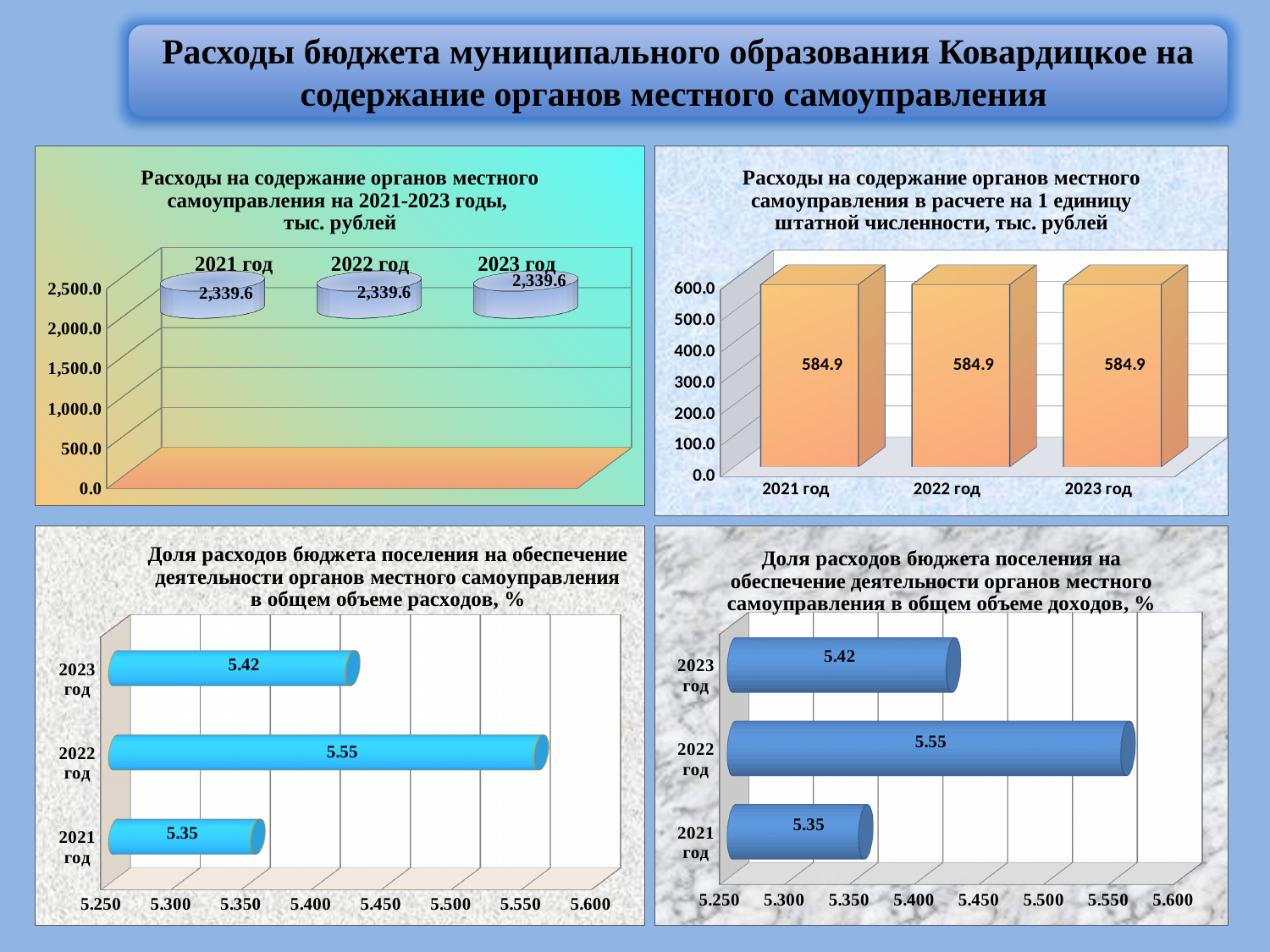
What kind of chart is the top-right chart? bar chart How many categories (years) are shown in the top-left chart? 3 In the bottom-left chart, which year has the highest value? 2022 год In the bottom-left chart (share of expenses in total expenditures, %), what is the value for 2021 год? 5.35 In the bottom-right chart (share of expenses in total revenues, %), what is the value for 2023 год? 5.42 In the top-right chart, is the value for 2021 год greater or less than 500.0? greater In the top-left chart (expenses on local self-government bodies for 2021-2023, thousand rubles), what is the value for 2022 год? 2,339.6 In the top-right chart (expenses per 1 staff unit, thousand rubles), what is the value for 2023 год? 584.9 In the bottom-right chart, which is larger: the value for 2021 год or 2023 год? 2023 год What kind of chart is the bottom-right chart? bar chart In the bottom-left chart, which year has the lowest value? 2021 год In the bottom-left chart, what is the difference between the values for 2022 год and 2023 год? 0.13